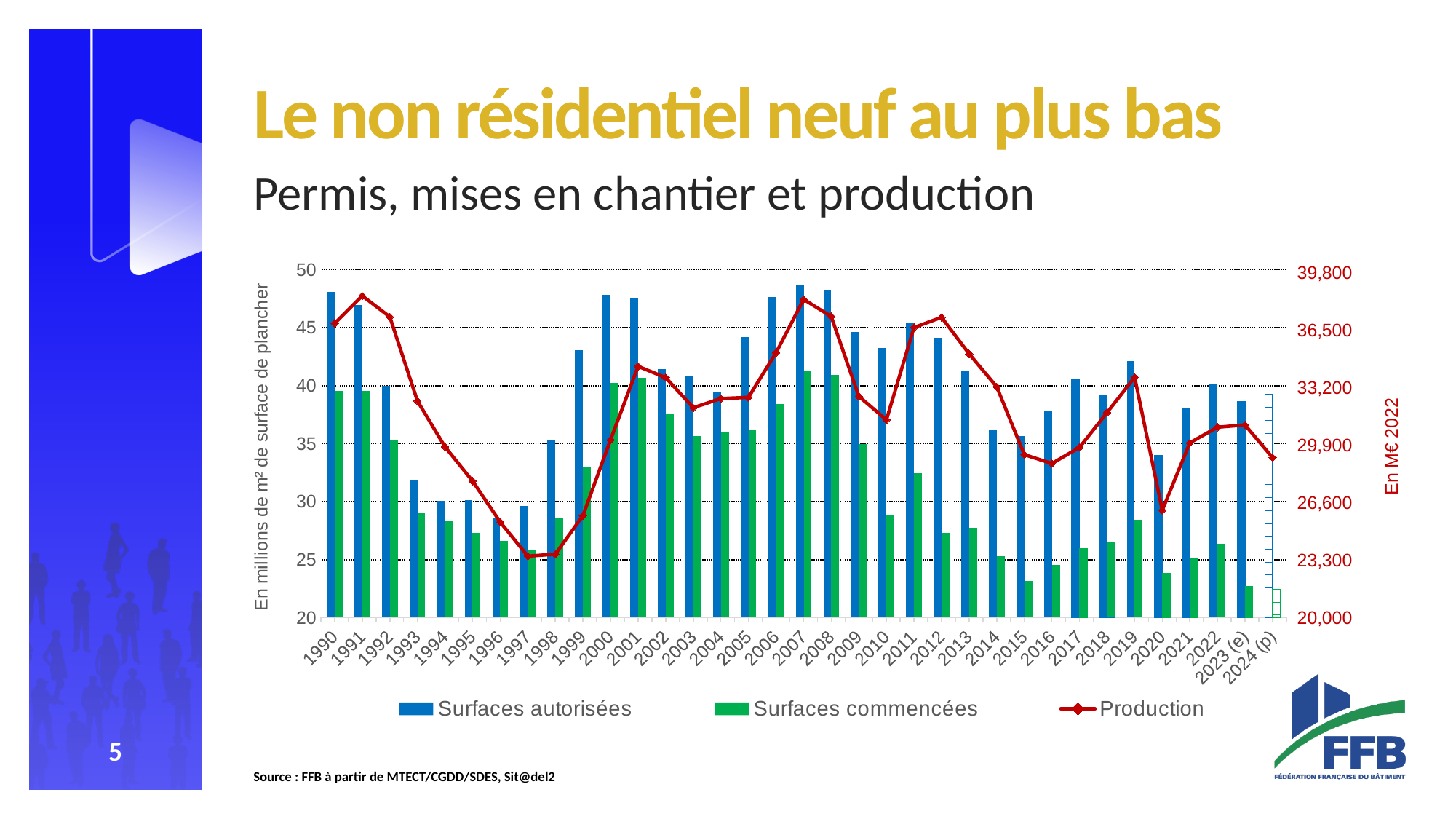
How many series does the chart legend list? 3 What kind of chart is shown on the slide? A combined bar and line chart Is the value of Surfaces autorisées for 1996 greater or less than 30? less Is the value of Surfaces commencées for 2007 greater or less than 40? greater What is the label of the left vertical axis of the chart? En millions de m² de surface de plancher How many years (categories) are shown on the x axis of the chart? 35 Is the value of Surfaces autorisées for 1990 greater or less than 45? greater Does the Production line rise or fall from 1991 to 1997? fall Which is larger, Surfaces commencées in 1992 or in 1993? 1992 Which is larger, Surfaces autorisées in 2000 or in 2010? 2000